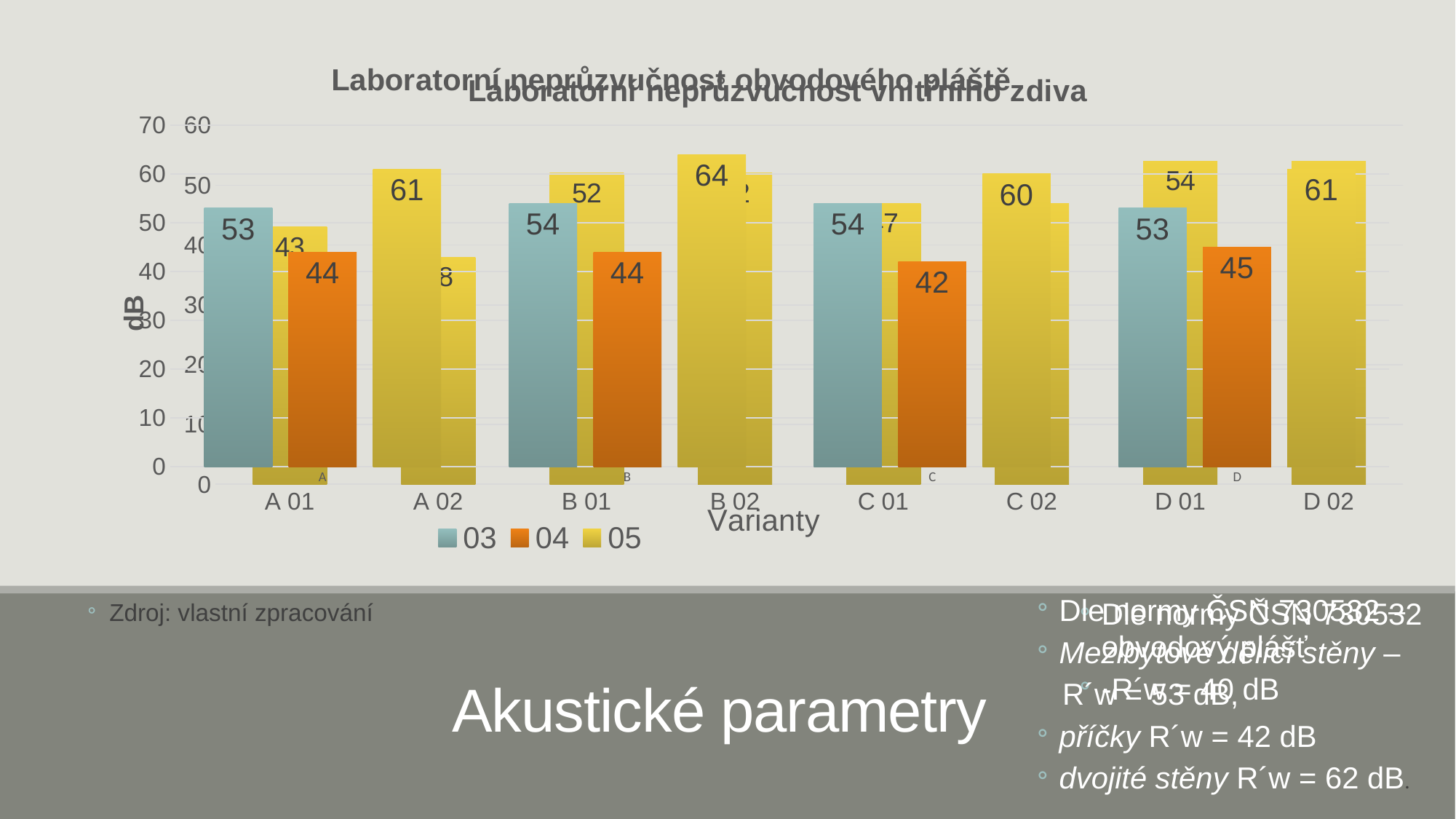
In the chart titled "Laboratorní neprůzvučnost vnitřního zdiva", which variant has the lowest value for series 04? C In the chart titled "Laboratorní neprůzvučnost vnitřního zdiva", how many series does the legend list? 3 In the chart titled "Laboratorní neprůzvučnost vnitřního zdiva", how many variants are shown on the x axis? 4 What kind of chart is "Laboratorní neprůzvučnost vnitřního zdiva"? Bar chart